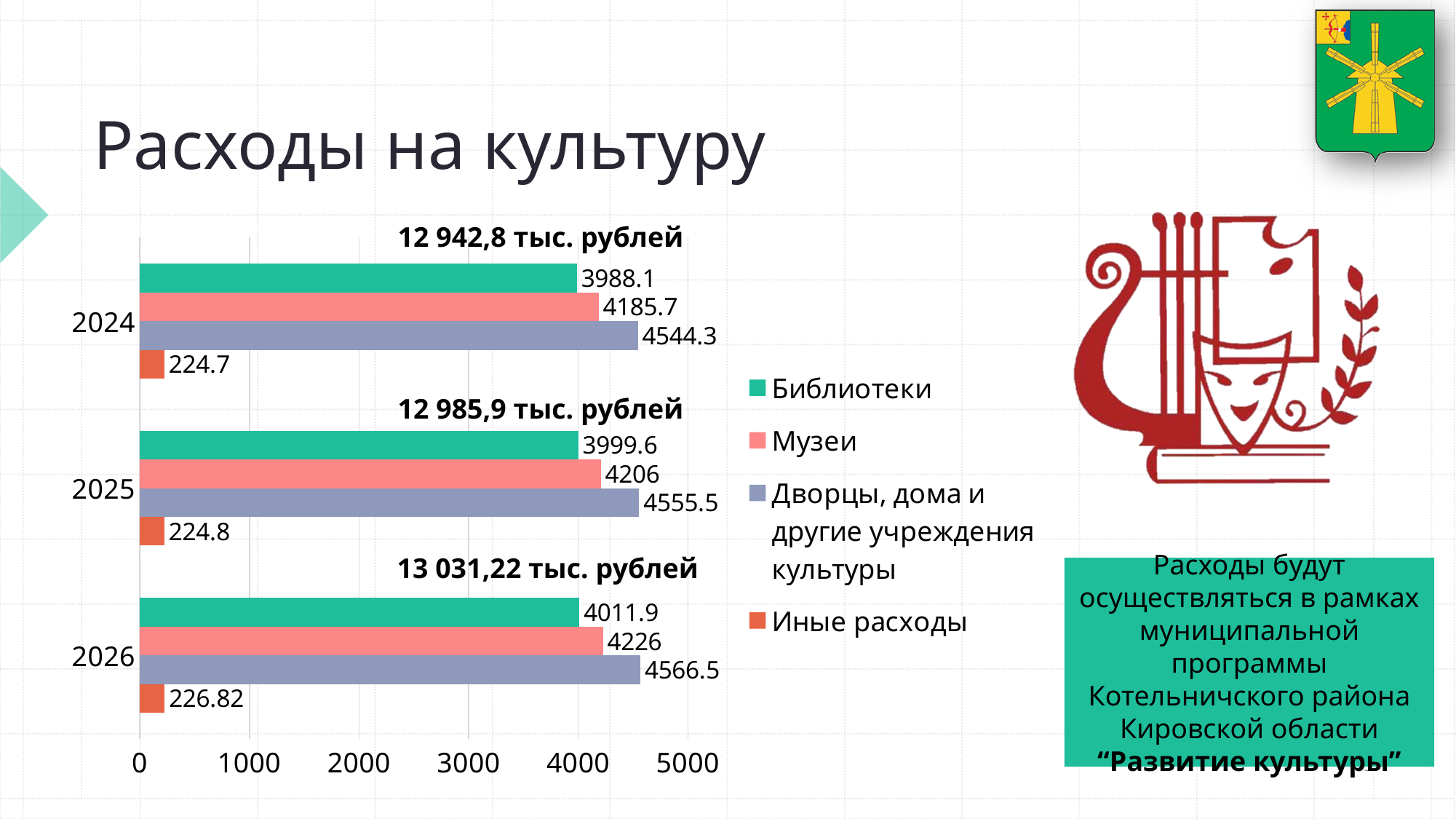
What is the value for Дворцы, дома и другие учреждения культуры in 2026? 4566.5 What kind of chart is shown on the slide? Bar chart What is the value for Музеи in 2026? 4226 Which is larger in 2026: the value for Библиотеки or the value for Музеи? Музеи What is the value for Библиотеки in 2024? 3988.1 What is the difference between the Музеи value and the Библиотеки value in 2025? 206.4 How many series does the legend list? 4 Which series has the highest value in 2025? Дворцы, дома и другие учреждения культуры Which series has the lowest value in 2024? Иные расходы Do the values for Библиотеки rise or fall from 2024 to 2026? Rise How many year categories are shown on the chart? 3 What is the value for Иные расходы in 2025? 224.8